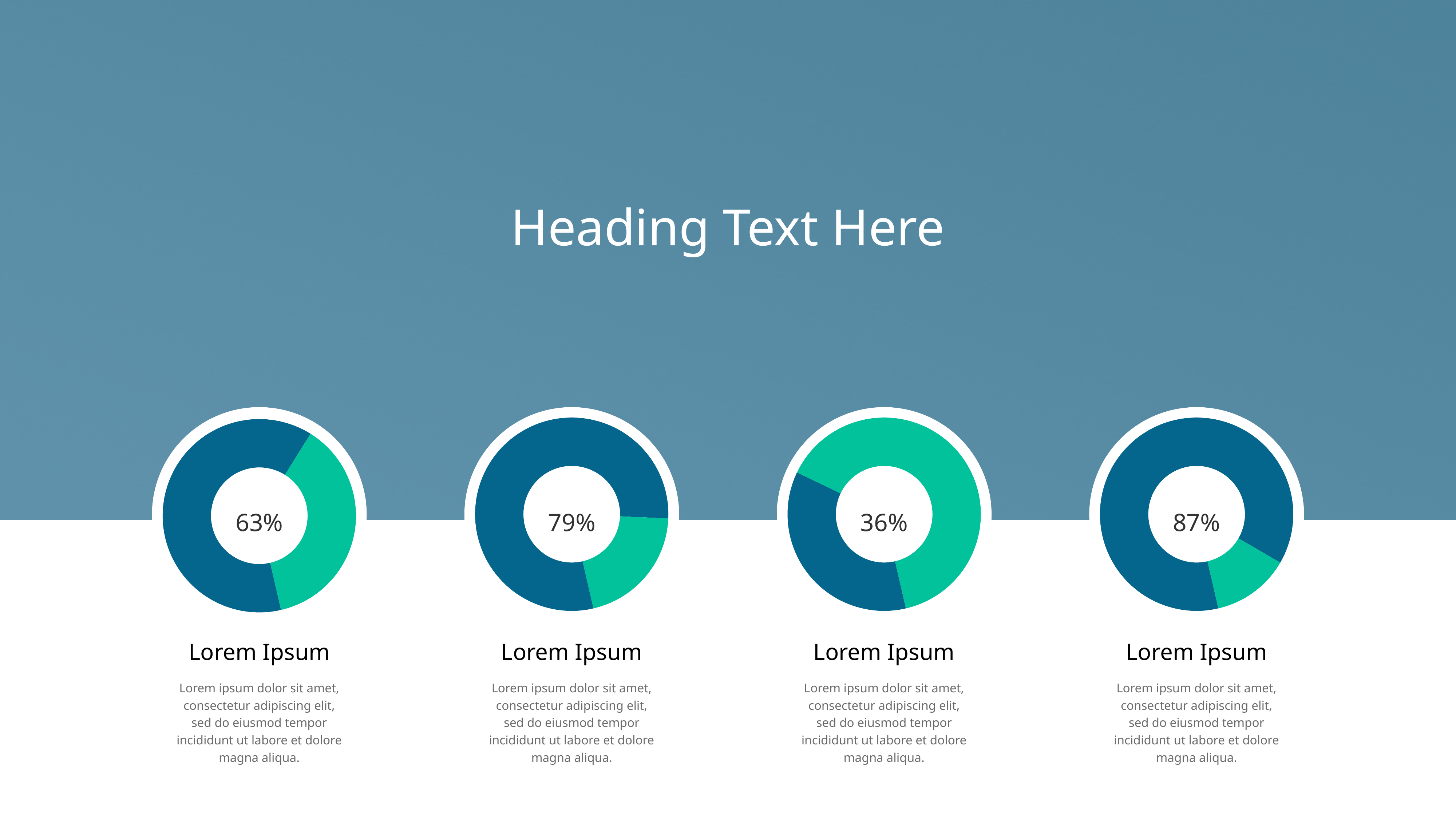
Which donut chart shows the lowest percentage? The third chart from the left (36%) Which is larger: the percentage in the leftmost donut chart or the percentage in the second donut chart from the left? The second donut chart (79%) What kind of chart is used to display the percentages on the slide? Donut chart What percentage is shown in the centre of the second donut chart from the left? 79% Which donut chart shows the highest percentage? The rightmost chart (87%) How many donut charts are on the slide? 4 What is the heading text at the top of the slide? Heading Text Here What is the difference between the percentage in the rightmost donut chart and the percentage in the third donut chart from the left? 51% What percentage is shown in the centre of the rightmost donut chart? 87% What percentage is shown in the centre of the third donut chart from the left? 36% What is the difference between the percentage in the second donut chart and the percentage in the leftmost donut chart? 16% What percentage is shown in the centre of the leftmost donut chart? 63%